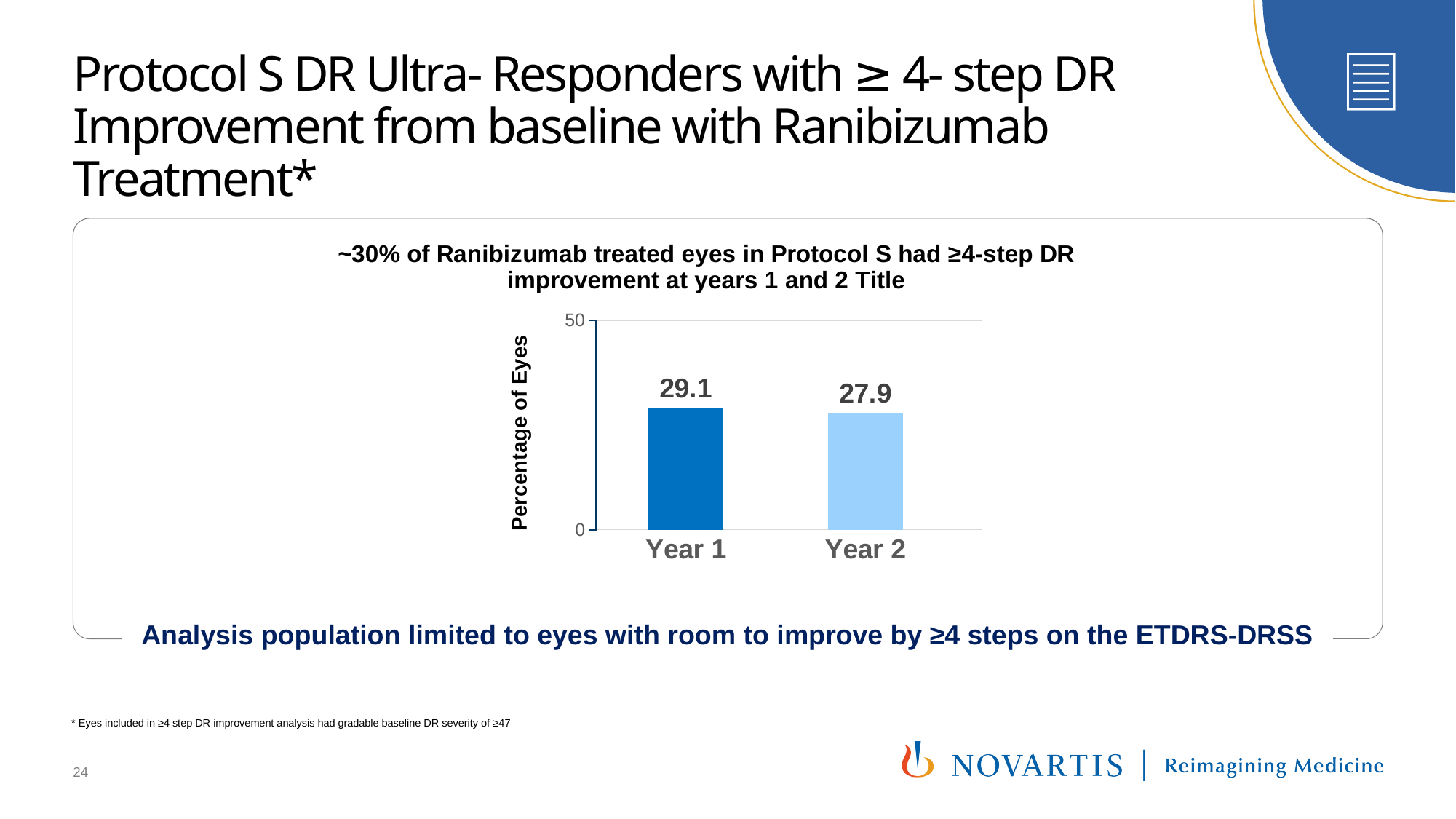
Do the values rise or fall from Year 1 to Year 2? fall What kind of chart is shown on the slide? bar chart How many categories are shown on the x axis? 2 Which category has the highest value? Year 1 What is the value for Year 1? 29.1 What is the difference between the Year 1 and Year 2 values? 1.2 Which is larger, the value for Year 1 or the value for Year 2? Year 1 What is the label of the y axis? Percentage of Eyes What is the value for Year 2? 27.9 What is the maximum value shown on the y axis? 50 Is the value for Year 1 greater or less than 50? less Which category has the lowest value? Year 2